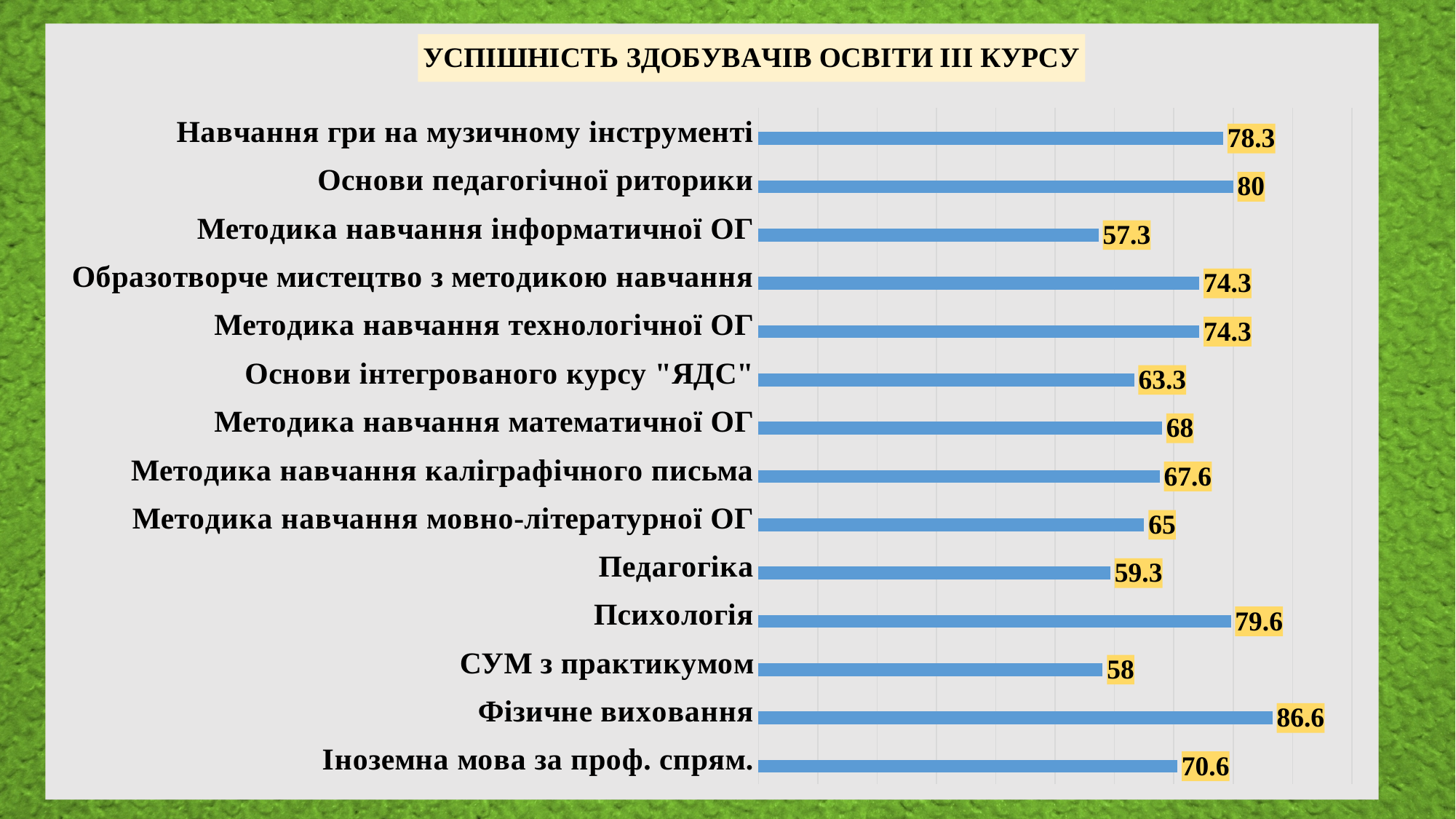
Which has a larger value, Психологія or Педагогіка? Психологія What is the value for Основи інтегрованого курсу "ЯДС"? 63.3 How many categories (subjects) are plotted in the chart? 14 Which subject has the lowest value? Методика навчання інформатичної ОГ What is the title of the chart? УСПІШНІСТЬ ЗДОБУВАЧІВ ОСВІТИ ІІІ КУРСУ What type of chart is shown on the slide? bar chart What is the value for Методика навчання каліграфічного письма? 67.6 What is the value for Фізичне виховання? 86.6 What is the difference between the values for Фізичне виховання and Методика навчання інформатичної ОГ? 29.3 What is the difference between the values for Психологія and Педагогіка? 20.3 Which subject has the highest value? Фізичне виховання What is the value for Іноземна мова за проф. спрям.? 70.6